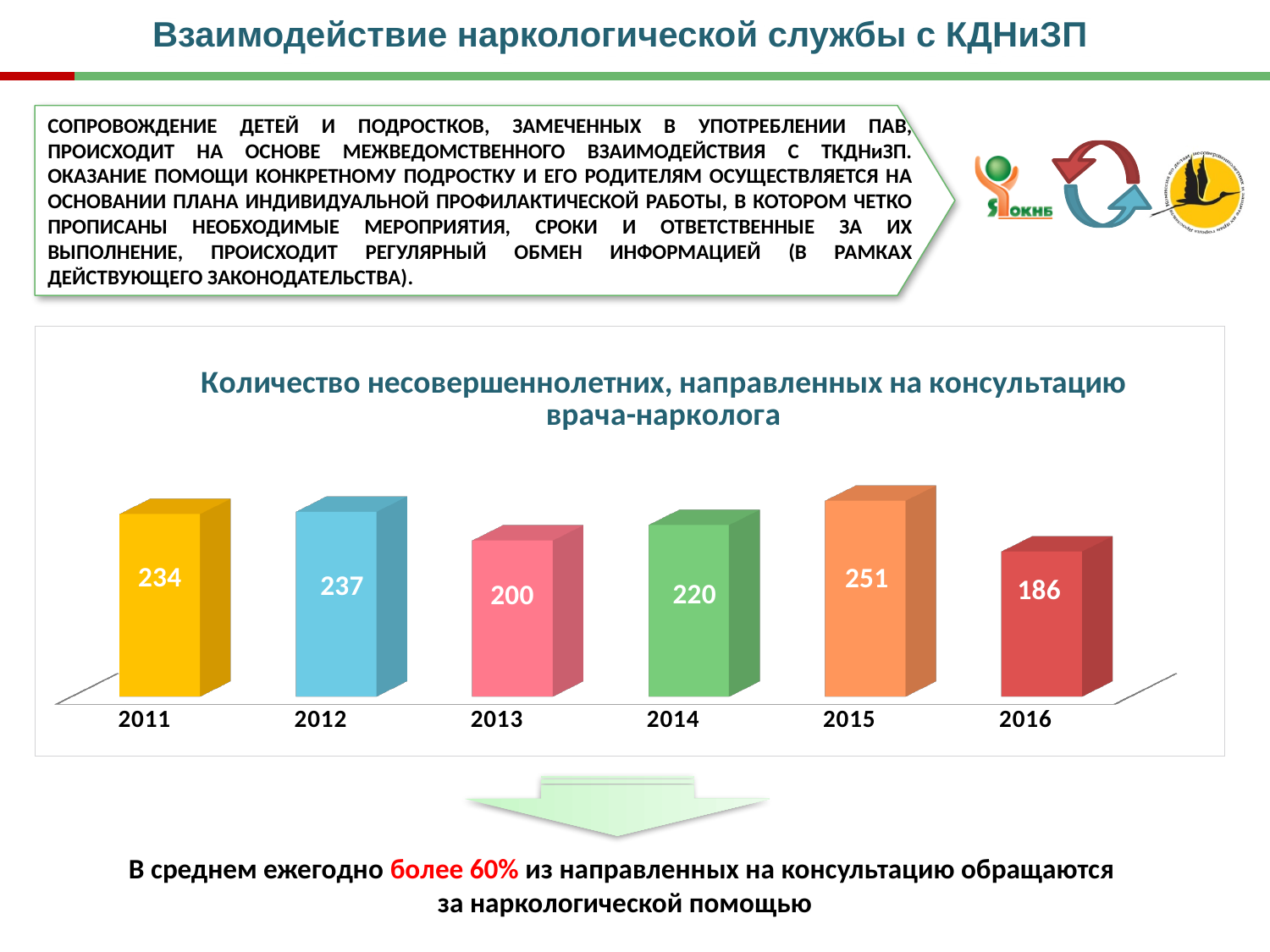
What is the difference between the values for 2012 and 2013? 37 Which year has the lowest value? 2016 Does the value rise or fall from 2015 to 2016? fall What is the title of the chart? Количество несовершеннолетних, направленных на консультацию врача-нарколога How many years are shown on the chart? 6 What is the value for 2016? 186 What kind of chart is this? bar chart What is the difference between the values for 2015 and 2016? 65 Which year has the highest value? 2015 Which is larger, the value for 2013 or the value for 2014? 2014 What is the value for 2015? 251 What is the value for 2011? 234